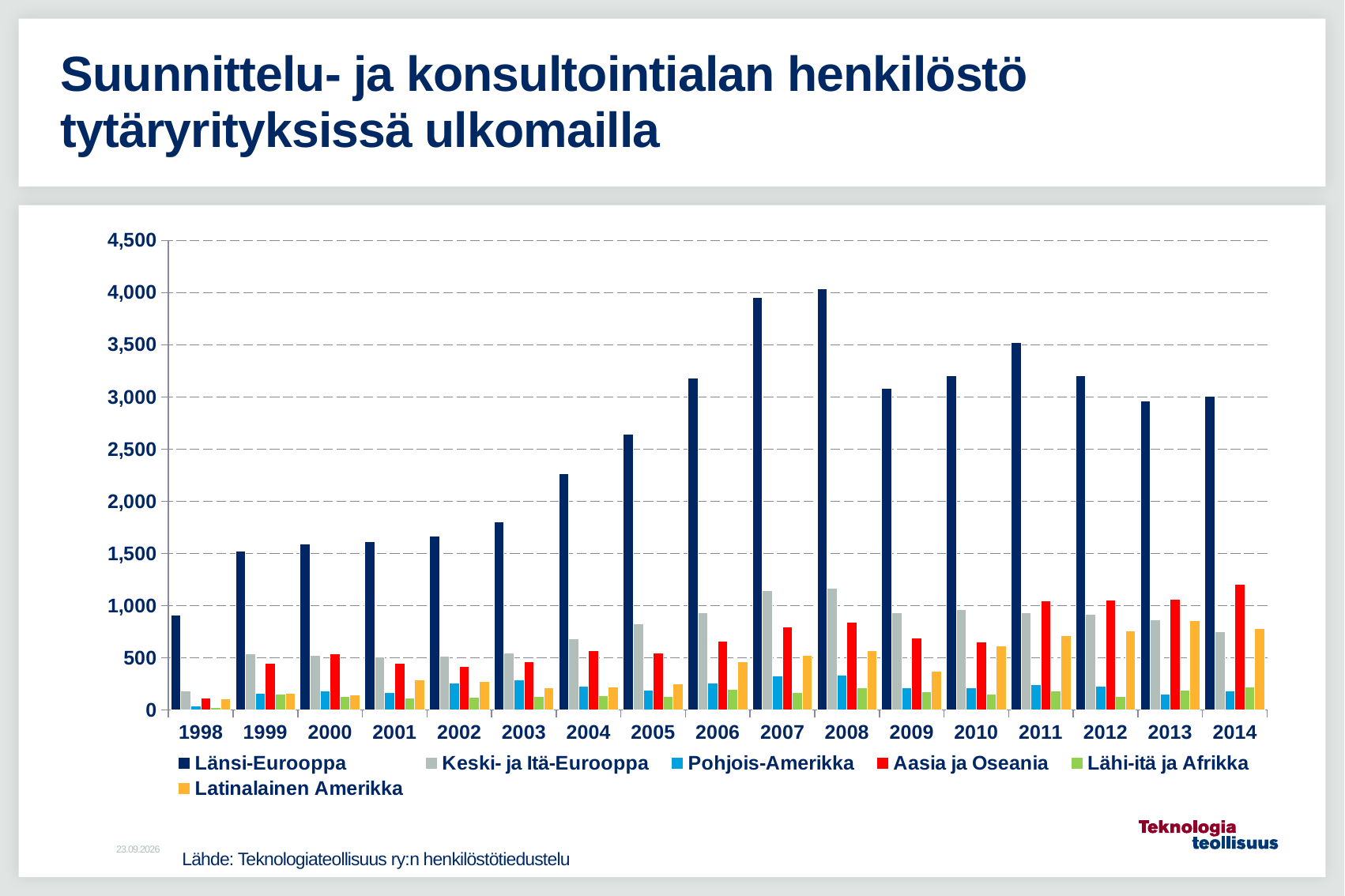
Is the value for Aasia ja Oseania in 2014 greater or less than 1,000? greater In which year is the value for Länsi-Eurooppa highest? 2008 How many series does the legend list? 6 In which year is the value for Aasia ja Oseania highest? 2014 In which year is the value for Latinalainen Amerikka highest? 2013 Is the value for Länsi-Eurooppa in 1998 greater or less than 1,000? less In 2014, which is larger: Aasia ja Oseania or Keski- ja Itä-Eurooppa? Aasia ja Oseania Is the value for Länsi-Eurooppa in 2007 greater or less than 3,500? greater Does the value for Länsi-Eurooppa rise or fall from 1998 to 2008? rise How many years are shown on the x axis? 17 In which year is the value for Länsi-Eurooppa lowest? 1998 What kind of chart is shown on the slide? bar chart